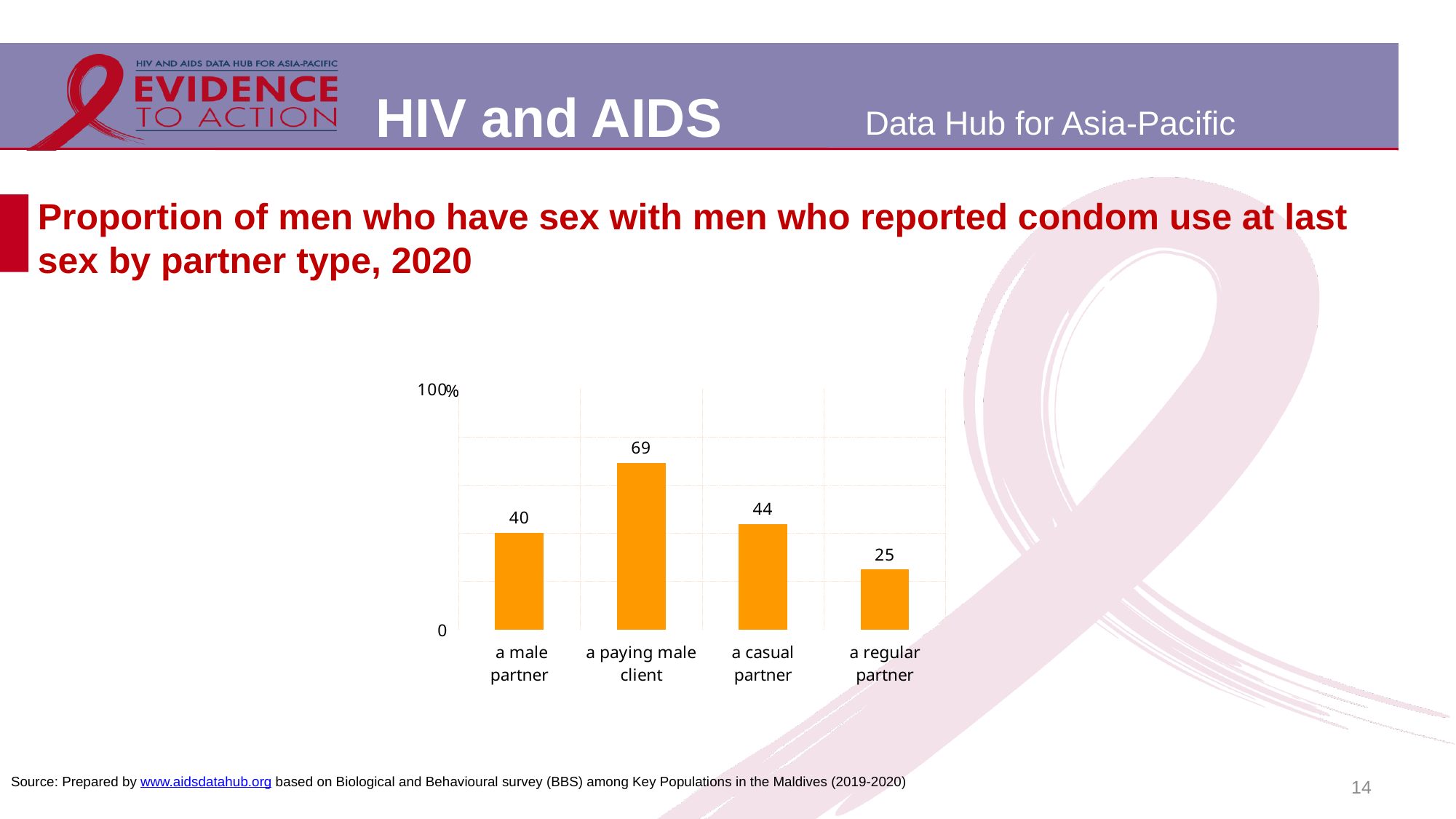
What is the value for a male partner? 40 Which partner type has the highest reported condom use at last sex? a paying male client What is the value for a casual partner? 44 How many partner types are shown in the chart? 4 What is the value for a regular partner? 25 Which partner type has the lowest reported condom use at last sex? a regular partner What is the difference between the values for a paying male client and a regular partner? 44 What is the maximum value shown on the vertical axis? 100% What is the difference between the values for a casual partner and a male partner? 4 Which is larger, the value for a casual partner or the value for a regular partner? a casual partner What kind of chart is shown on the slide? bar chart What is the value for a paying male client? 69